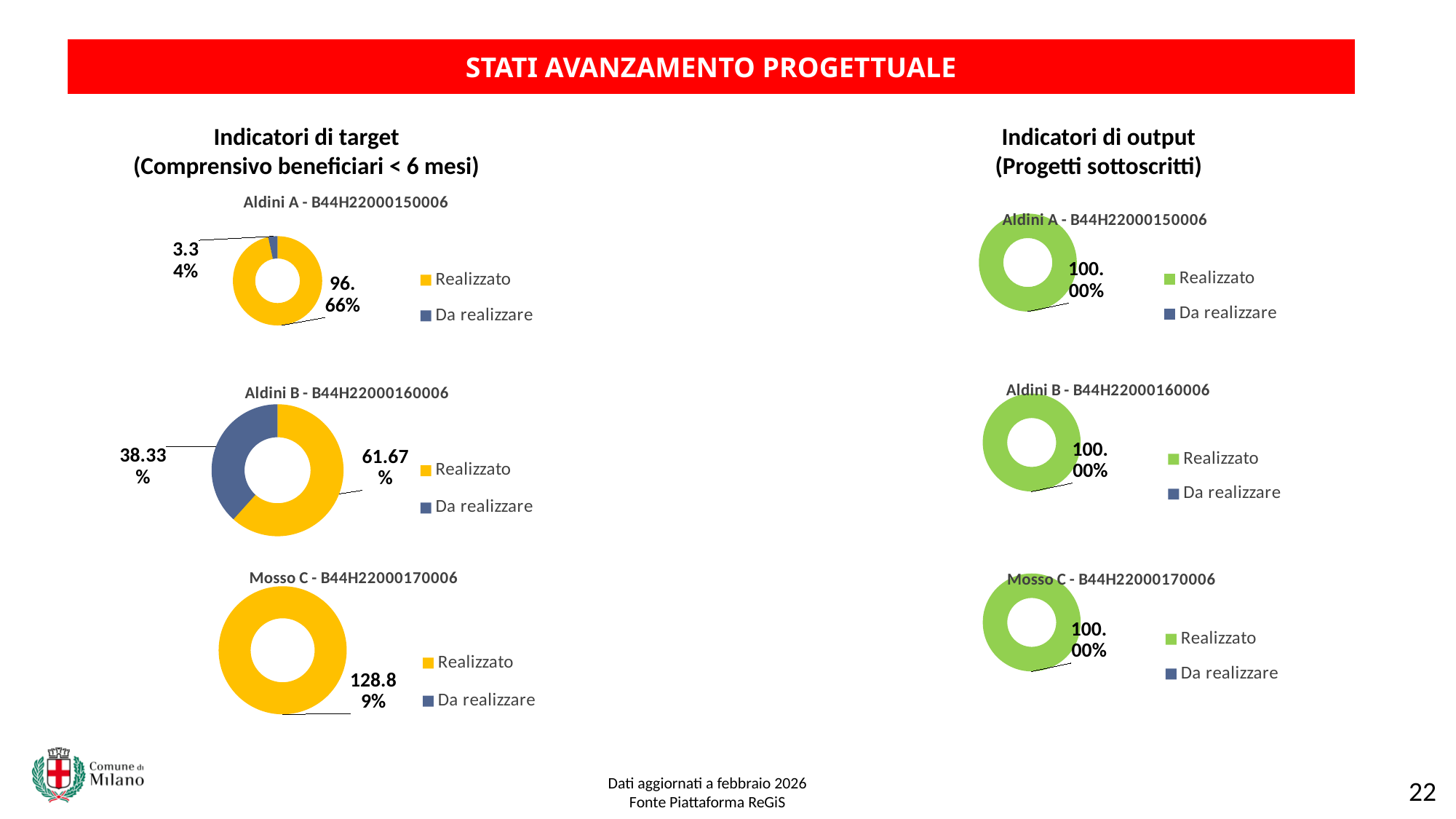
In the 'Indicatori di target' chart for Aldini A - B44H22000150006, what is the value for Realizzato? 96.66% In the 'Indicatori di target' chart for Mosso C - B44H22000170006, what is the value for Realizzato? 128.89% How many series does the legend list for the 'Indicatori di output' chart for Mosso C - B44H22000170006? 2 In the 'Indicatori di target' chart for Aldini B - B44H22000160006, what is the difference between Realizzato and Da realizzare? 23.34% What kind of chart is used for Aldini A - B44H22000150006 under 'Indicatori di target'? Donut (pie) chart In the 'Indicatori di output' chart for Aldini A - B44H22000150006, what is the value for Realizzato? 100.00% In the 'Indicatori di target' chart for Aldini B - B44H22000160006, what is the value for Realizzato? 61.67% In the 'Indicatori di target' chart for Aldini A - B44H22000150006, what is the value for Da realizzare? 3.34% In the 'Indicatori di target' chart for Aldini B - B44H22000160006, what is the value for Da realizzare? 38.33% In the 'Indicatori di target' chart for Aldini B - B44H22000160006, which is larger, Realizzato or Da realizzare? Realizzato What colour represents Realizzato in the 'Indicatori di output' charts? Green In the 'Indicatori di target' chart for Aldini A - B44H22000150006, what is the difference between Realizzato and Da realizzare? 93.32%